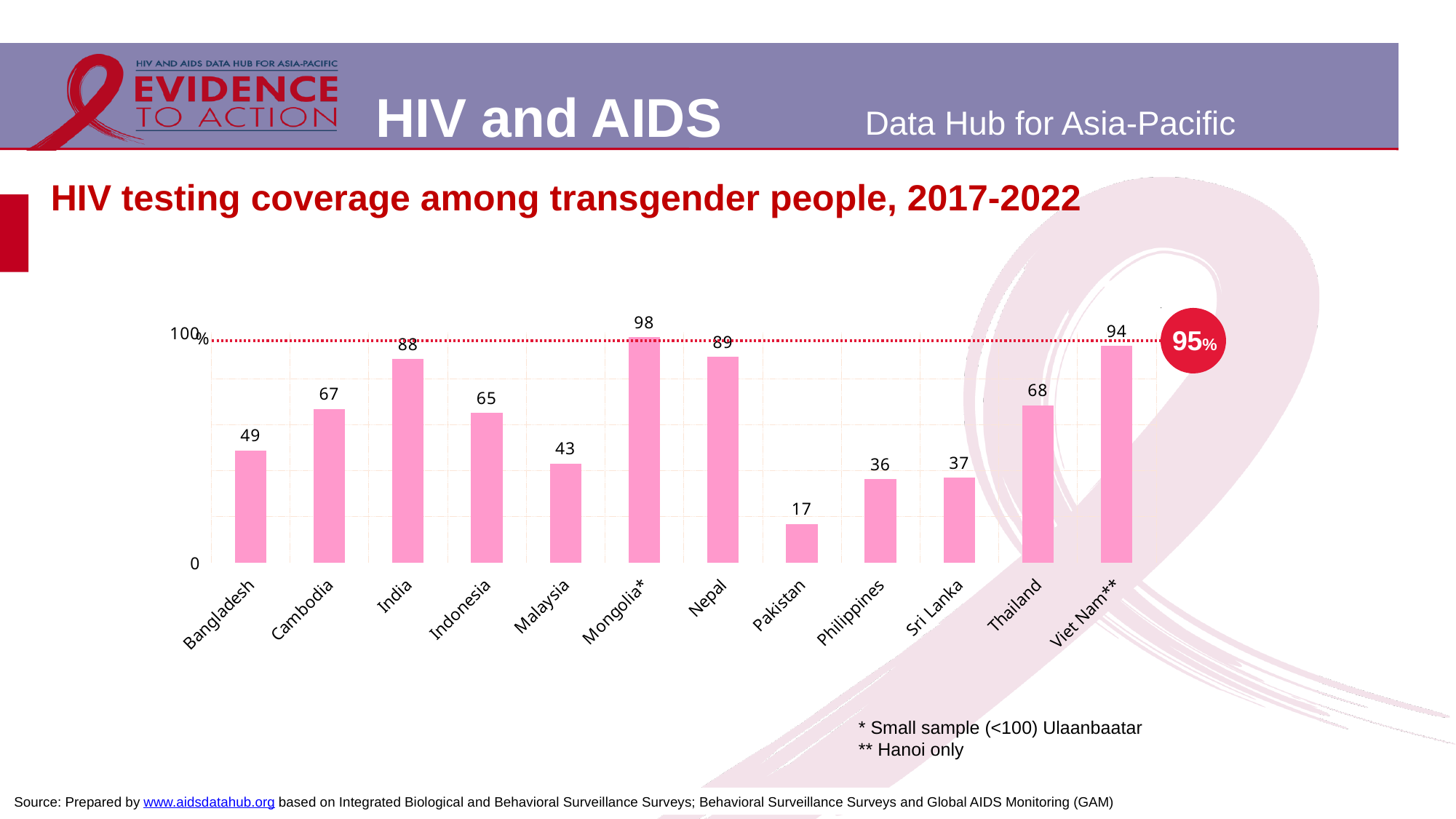
Which has a higher value, Cambodia or Indonesia? Cambodia How many countries are shown on the chart? 12 What is the value shown for Pakistan? 17 Which country has the lowest HIV testing coverage on the chart? Pakistan What is the title of the chart? HIV testing coverage among transgender people, 2017-2022 What kind of chart is shown on the slide? Bar chart What is the value shown for Thailand? 68 What is the HIV testing coverage value shown for Bangladesh? 49 What target percentage is marked by the dotted red line on the chart? 95% What is the difference between the values for Viet Nam** and Thailand? 26 Is the value for Malaysia greater or less than 50? less Which country has the highest HIV testing coverage on the chart? Mongolia*